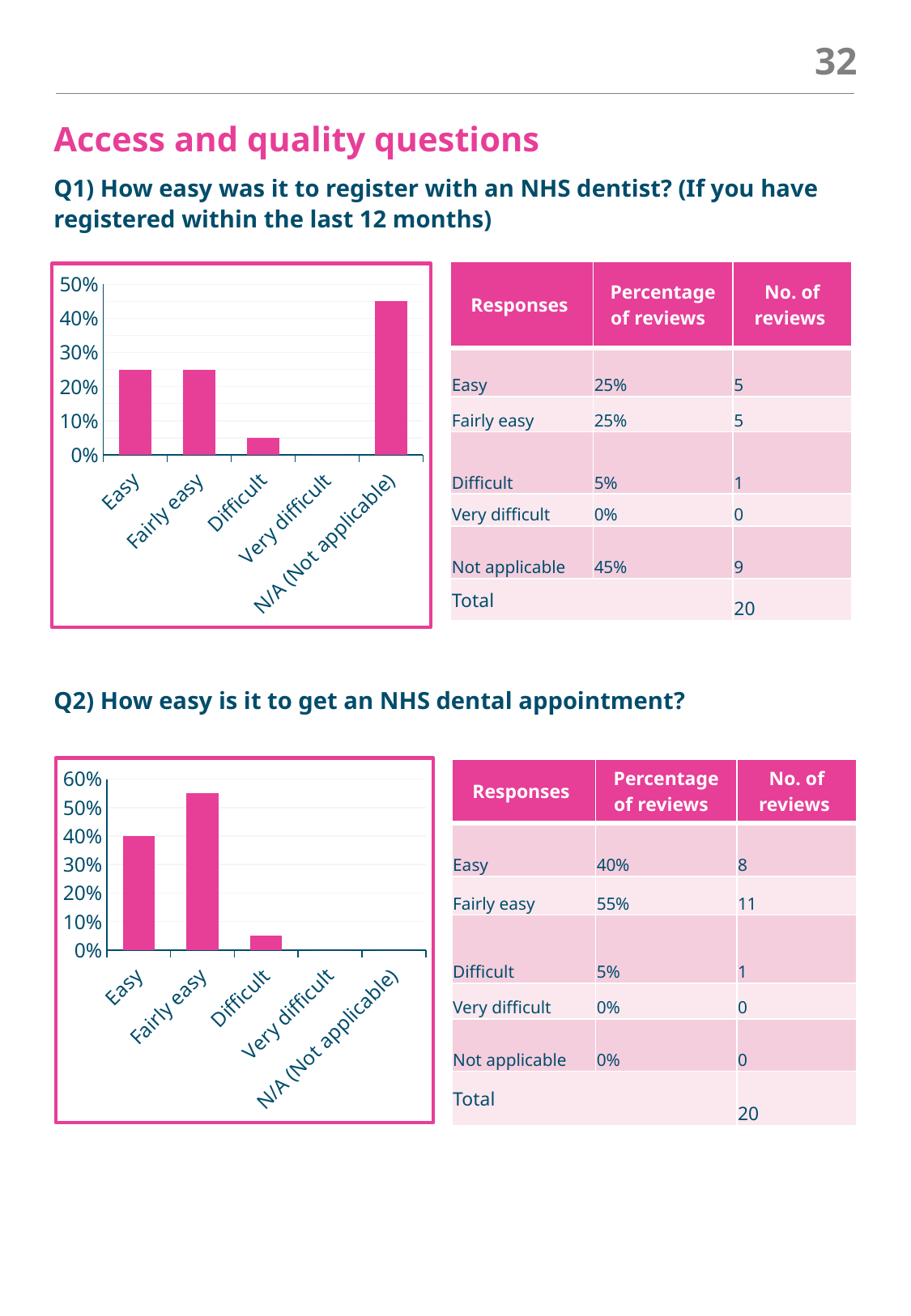
In the Q2 chart (bottom), which is larger, Easy or Difficult? Easy In the Q1 chart (top), what is the value for Difficult? 5% In the Q1 chart (top), which category has the highest bar? N/A (Not applicable) In the Q1 chart (top), what is the difference between the values for N/A (Not applicable) and Easy? 20% In the Q2 chart (bottom), is the value for Fairly easy greater or less than 50%? greater In the Q2 chart (bottom), what is the difference between the values for Fairly easy and Easy? 15% In the Q2 chart (bottom), which category has the highest bar? Fairly easy What kind of chart is shown for Q1 (the top chart)? Bar chart How many categories are shown on the x axis of the Q1 chart (top)? 5 What is the highest tick value shown on the y axis of the Q2 chart (bottom)? 60% In the Q1 chart (top), is the value for Easy greater or less than 20%? greater In the Q2 chart (bottom), what is the value for Easy? 40%